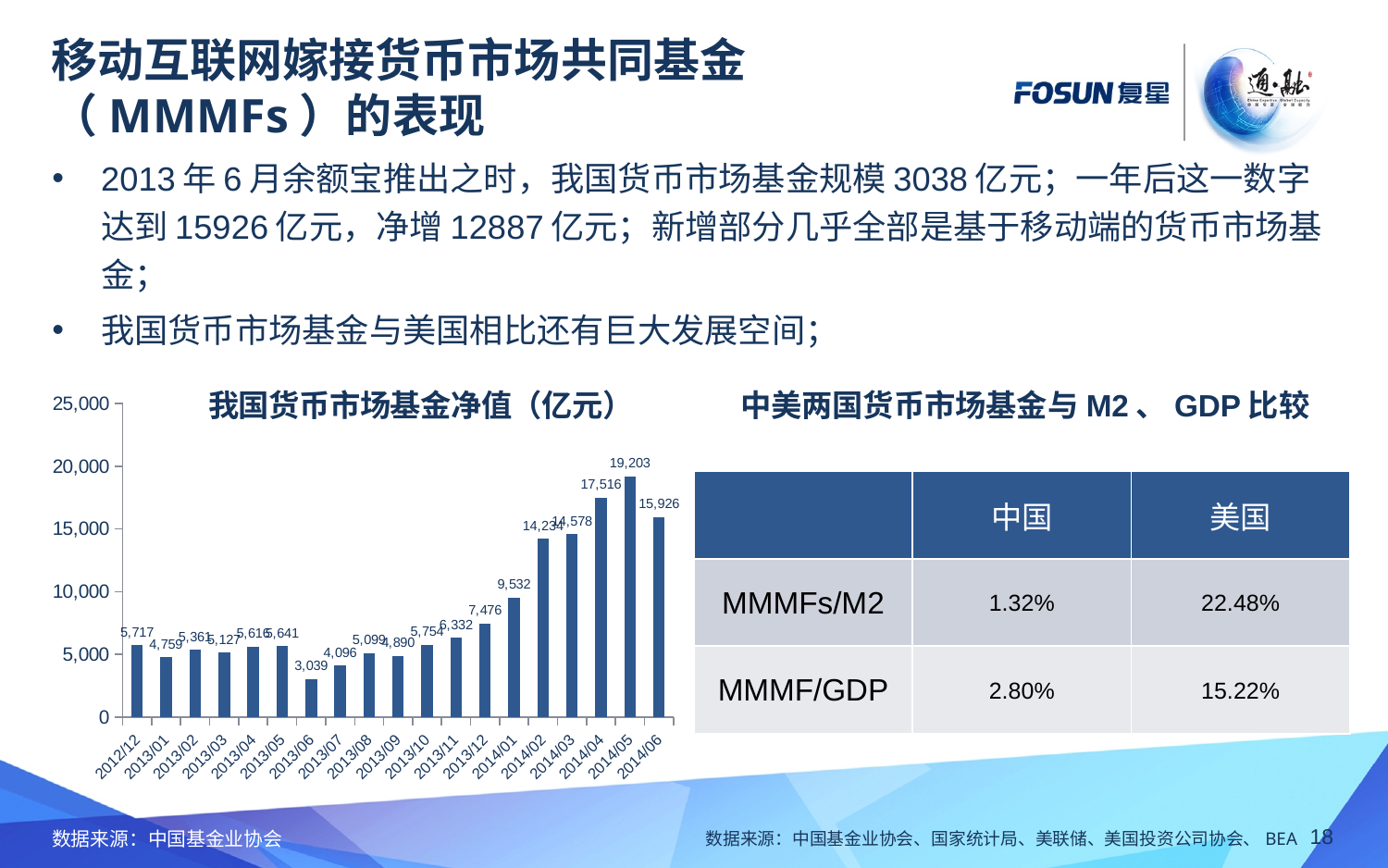
What is the value for 2012/12 in the chart? 5,717 Which is larger, the value for 2014/04 or the value for 2014/06? 2014/04 What is the title of the chart? 我国货币市场基金净值（亿元） What is the value for 2014/06 in the chart? 15,926 What is the value for 2013/06 in the chart? 3,039 Is the value for 2014/04 greater or less than 15,000? greater What type of chart is shown on the slide? bar chart Which month has the lowest value in the chart? 2013/06 What is the value for 2014/05 in the chart 我国货币市场基金净值（亿元）? 19,203 What is the difference between the values for 2014/05 and 2014/06? 3,277 Which month has the highest value in the chart? 2014/05 How many months are plotted in the chart? 19